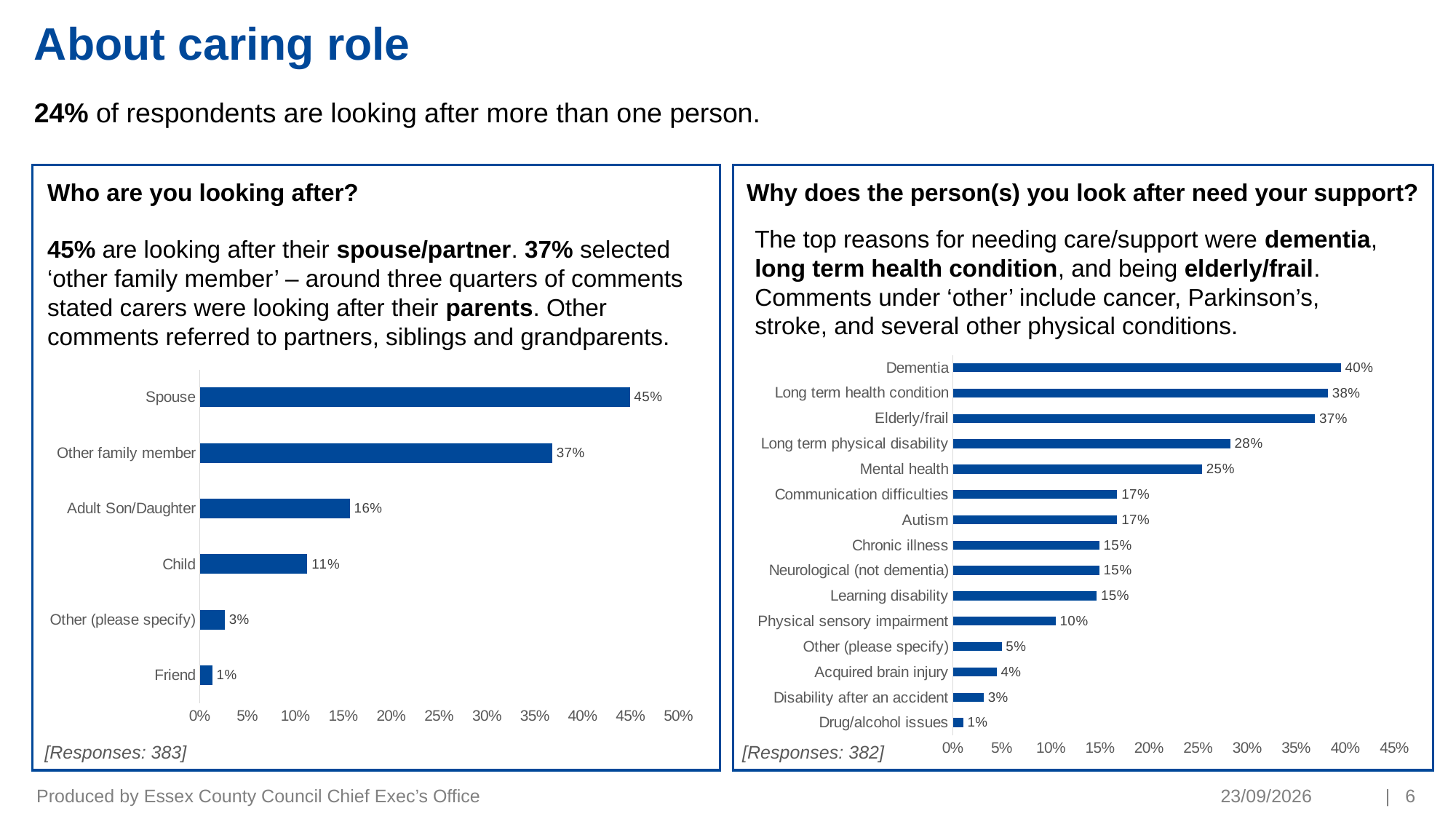
In the 'Who are you looking after?' chart, what is the value for Other family member? 37% In the 'Why does the person(s) you look after need your support?' chart, what is the value for Mental health? 25% In the 'Who are you looking after?' chart, which category has the lowest value? Friend In the 'Who are you looking after?' chart, which category has the highest value? Spouse In the 'Why does the person(s) you look after need your support?' chart, what is the difference between the values for Dementia and Elderly/frail? 3% What kind of chart is the 'Who are you looking after?' chart? Bar chart In the 'Why does the person(s) you look after need your support?' chart, which category has the lowest value? Drug/alcohol issues In the 'Why does the person(s) you look after need your support?' chart, which is larger: Long term physical disability or Mental health? Long term physical disability In the 'Why does the person(s) you look after need your support?' chart, which category has the highest value? Dementia In the 'Who are you looking after?' chart, what is the difference between the values for Adult Son/Daughter and Child? 5% In the 'Why does the person(s) you look after need your support?' chart, how many categories are shown? 15 In the 'Who are you looking after?' chart, how many categories are shown? 6